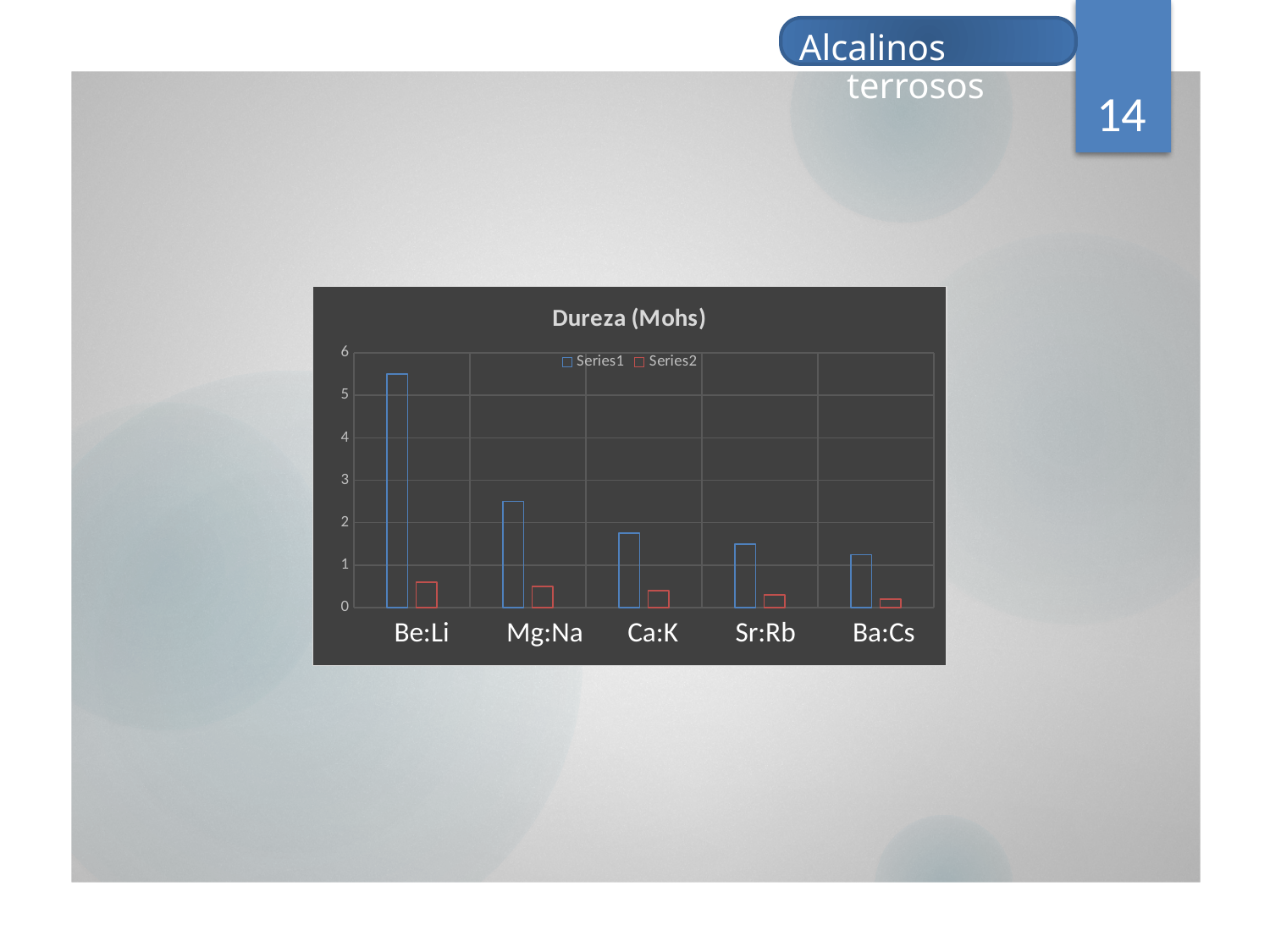
What kind of chart is shown on the slide? bar chart Is the Series1 value for Mg:Na greater or less than 3? less What is the title of the chart? Dureza (Mohs) How many series does the legend list? 2 Is the Series1 value for Be:Li greater or less than 5? greater Which category has the highest Series1 value? Be:Li Do the Series1 values rise or fall from Be:Li to Ba:Cs? fall Which category has the highest Series2 value? Be:Li How many categories are shown on the x axis? 5 Which category has the lowest Series1 value? Ba:Cs Is the Series2 value for Ba:Cs greater or less than 1? less Which is larger, the Series1 value for Be:Li or the Series1 value for Mg:Na? Be:Li